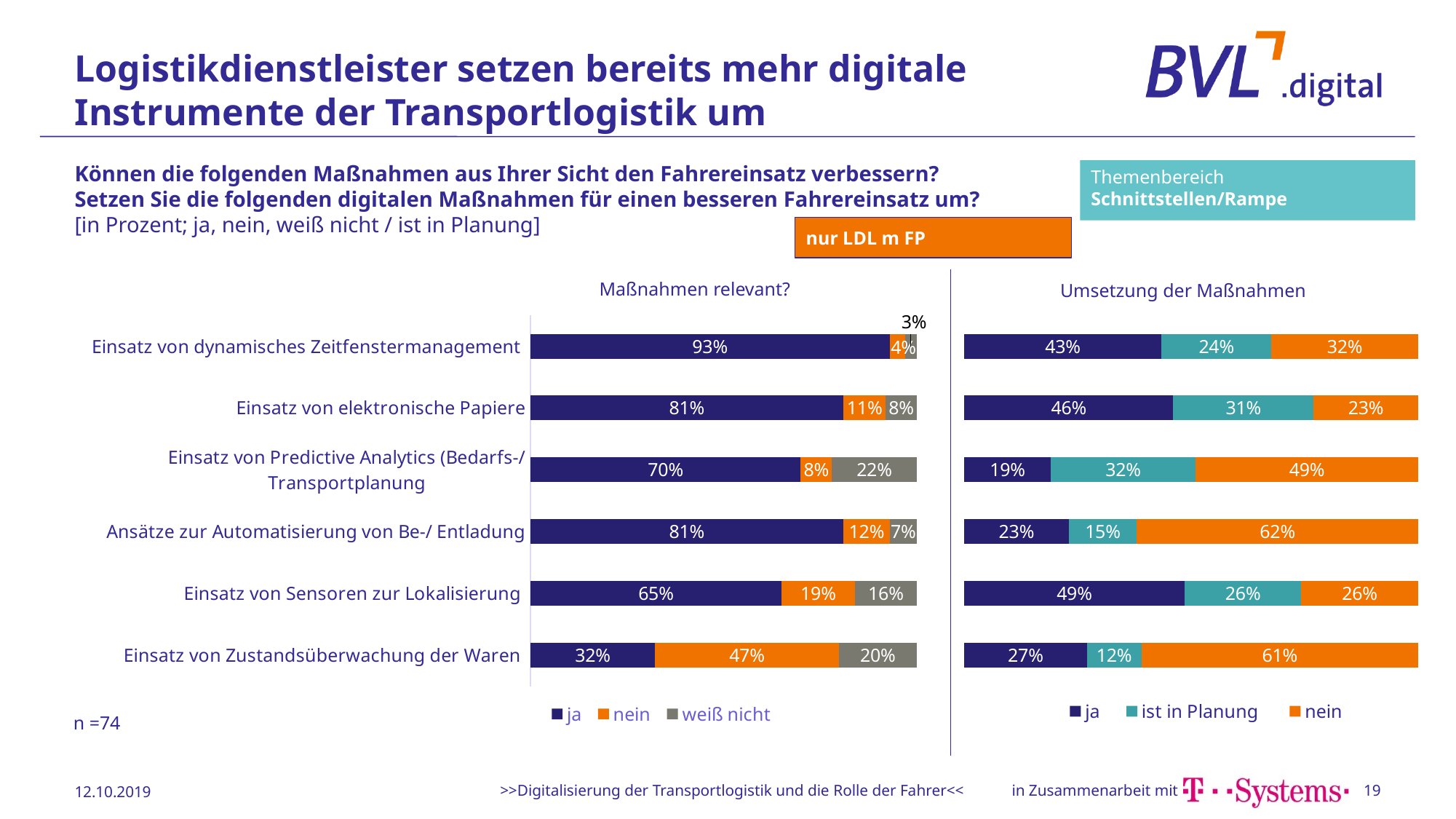
How many series does the legend of the 'Umsetzung der Maßnahmen' chart list? 3 In the 'Maßnahmen relevant?' chart, what is the 'ja' value for Einsatz von dynamisches Zeitfenstermanagement? 93% In the 'Umsetzung der Maßnahmen' chart, which is larger: the 'ist in Planung' value for Einsatz von elektronische Papiere or for Einsatz von Zustandsüberwachung der Waren? Einsatz von elektronische Papiere In the 'Umsetzung der Maßnahmen' chart, which measure has the lowest 'ja' value? Einsatz von Predictive Analytics (Bedarfs-/ Transportplanung) How many measures (categories) are shown in the 'Maßnahmen relevant?' chart? 6 In the 'Maßnahmen relevant?' chart, which measure has the highest 'nein' value? Einsatz von Zustandsüberwachung der Waren In the 'Maßnahmen relevant?' chart, what is the difference between the 'ja' values for Einsatz von Sensoren zur Lokalisierung and Einsatz von Zustandsüberwachung der Waren? 33% In the 'Umsetzung der Maßnahmen' chart, what is the 'nein' value for Ansätze zur Automatisierung von Be-/ Entladung? 62% What type of chart is the 'Umsetzung der Maßnahmen' chart? Stacked bar chart In the 'Umsetzung der Maßnahmen' chart, what is the 'ja' value for Einsatz von Sensoren zur Lokalisierung? 49% What are the legend entries of the 'Maßnahmen relevant?' chart? ja, nein, weiß nicht In the 'Maßnahmen relevant?' chart, what is the 'weiß nicht' value for Einsatz von Predictive Analytics (Bedarfs-/ Transportplanung)? 22%